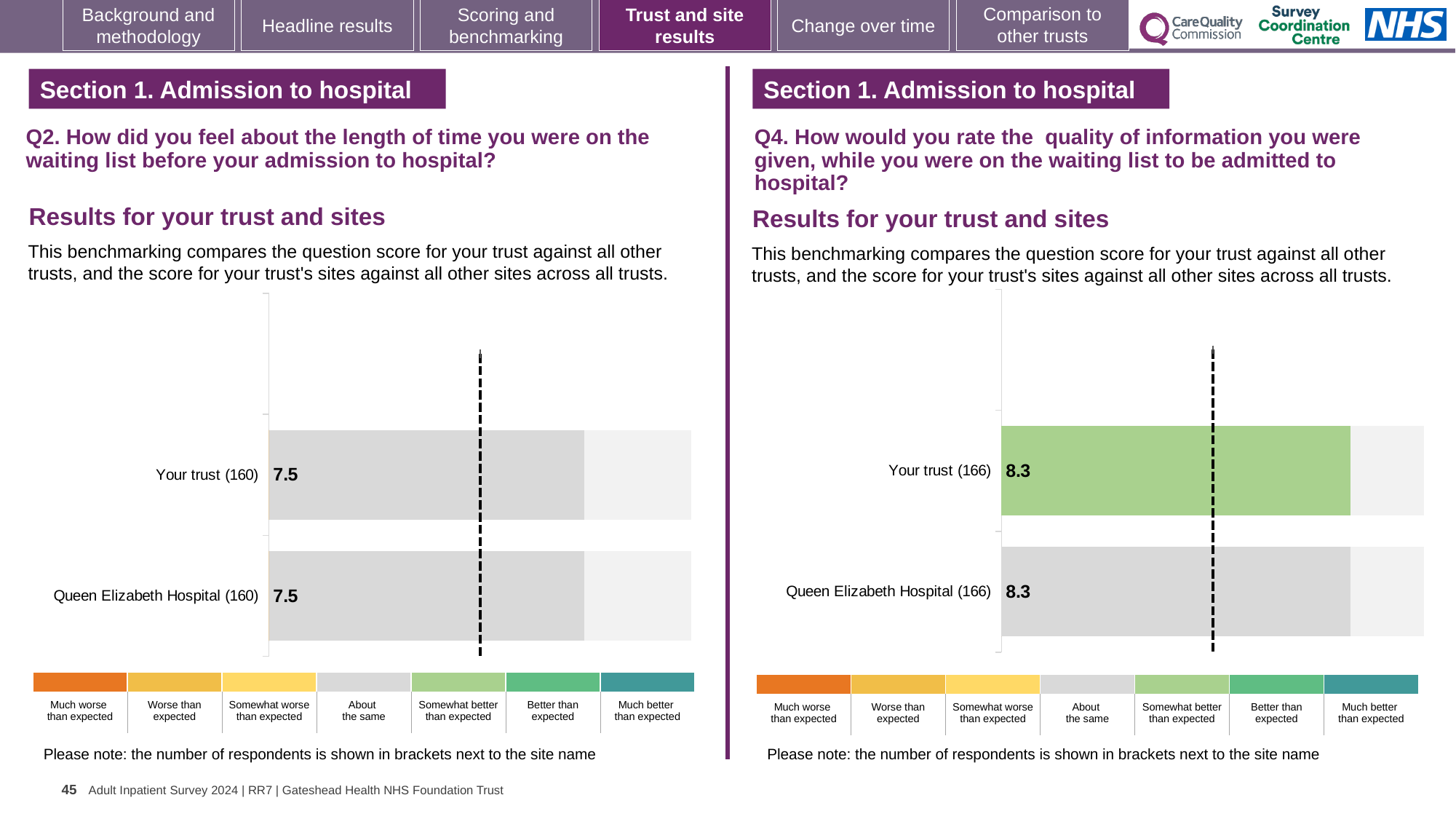
What kind of chart is the Q4 chart (right)? Bar chart On the Q4 chart (right), what is the score for Queen Elizabeth Hospital? 8.3 How many bars are plotted on the Q4 chart (right)? 2 On the Q2 chart (left), what is the difference between the score for Your trust and the score for Queen Elizabeth Hospital? 0 On the Q4 chart (right), how many respondents are shown in brackets for Queen Elizabeth Hospital? 166 On the Q4 chart (right), what is the difference between the score for Your trust and the score for Queen Elizabeth Hospital? 0 On the Q2 chart (left), how many respondents are shown in brackets for Your trust? 160 On the Q2 chart (left), what is the score for Queen Elizabeth Hospital? 7.5 On the Q2 chart (left), what is the score for Your trust? 7.5 How many bars are plotted on the Q2 chart (left)? 2 On the Q4 chart (right), which benchmark category does the green colour of the Your trust bar correspond to in the legend? Somewhat better than expected On the Q4 chart (right), what is the score for Your trust? 8.3